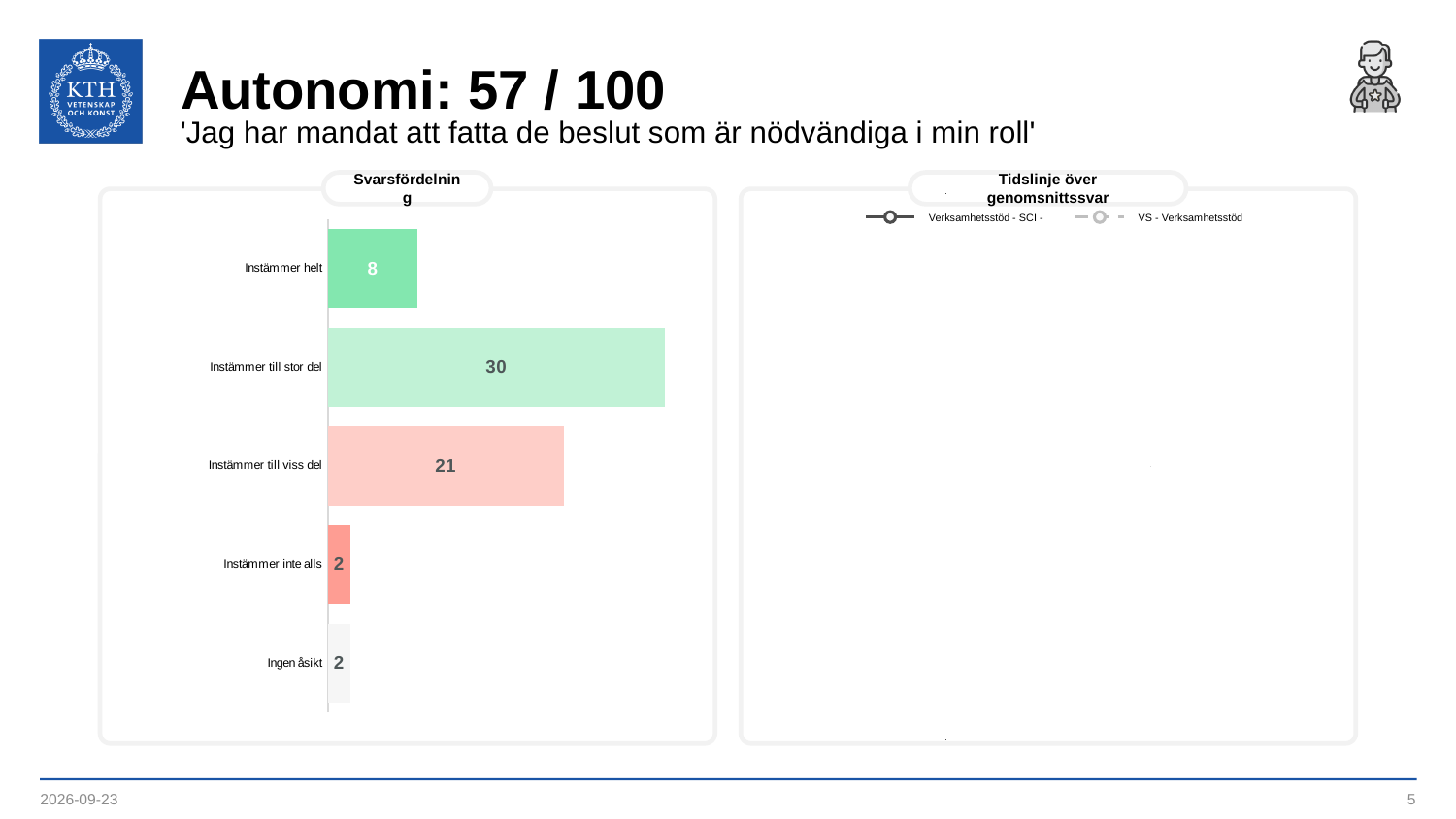
In the 'Svarsfördelning' chart, which is larger: 'Instämmer helt' or 'Instämmer till viss del'? Instämmer till viss del How many series does the legend of the 'Tidslinje över genomsnittssvar' chart list? 2 In the 'Svarsfördelning' chart, what is the value for 'Instämmer helt'? 8 In the 'Svarsfördelning' chart, which category has the highest value? Instämmer till stor del In the 'Svarsfördelning' chart, what is the difference between 'Instämmer till stor del' and 'Instämmer till viss del'? 9 In the 'Svarsfördelning' chart, what is the difference between 'Instämmer till viss del' and 'Instämmer helt'? 13 What is the title of the chart on the left side of the slide? Svarsfördelning How many categories are shown in the 'Svarsfördelning' chart? 5 In the 'Svarsfördelning' chart, what is the value for 'Instämmer till viss del'? 21 In the 'Svarsfördelning' chart, what is the value for 'Ingen åsikt'? 2 In the 'Svarsfördelning' chart, what is the value for 'Instämmer till stor del'? 30 What kind of chart is the 'Svarsfördelning' chart? Bar chart